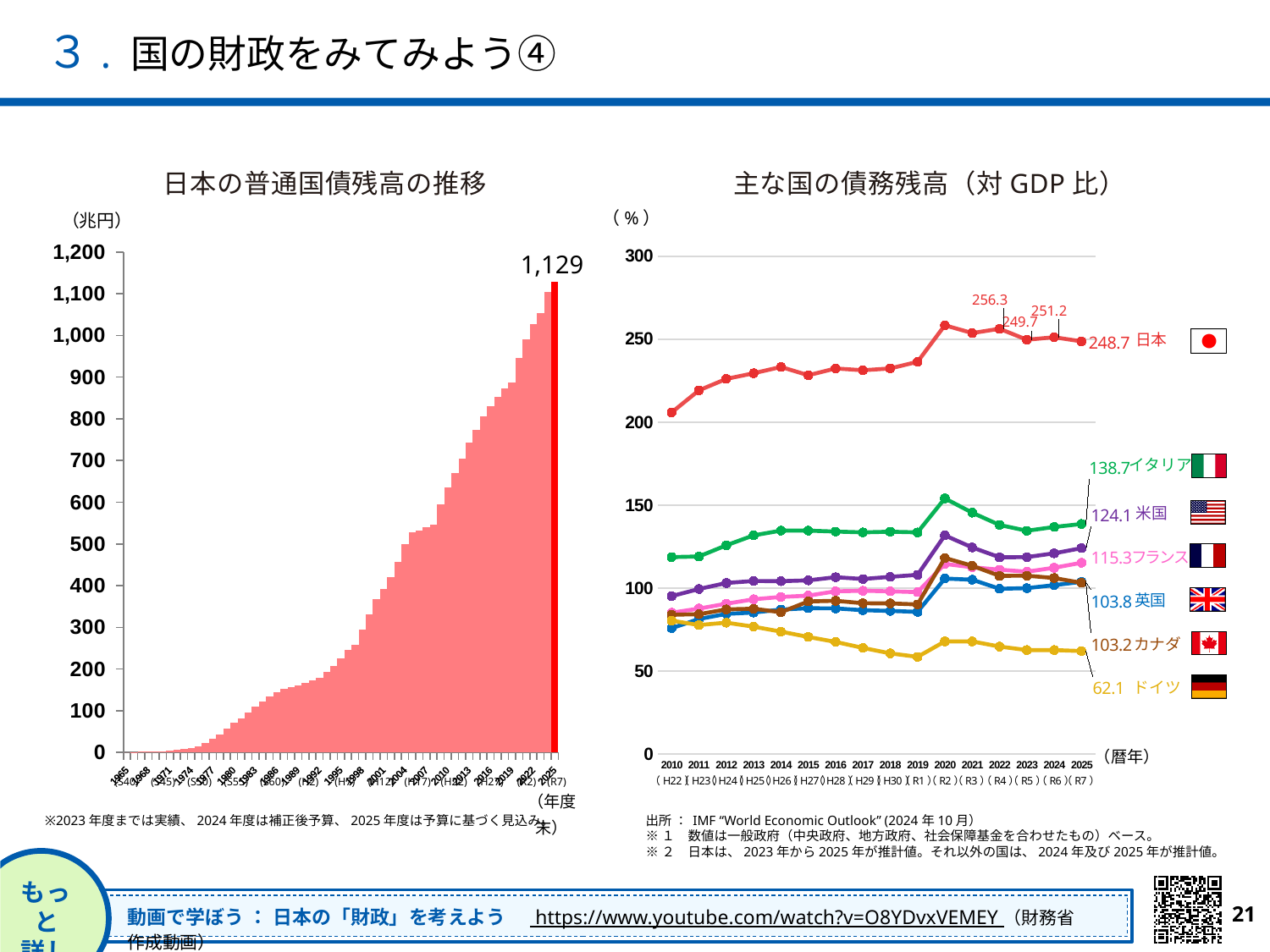
In the chart titled 主な国の債務残高（対GDP比）, what is the 2025 value for イタリア? 138.7 What kind of chart is the left chart, 日本の普通国債残高の推移? bar chart How many countries are plotted in the chart titled 主な国の債務残高（対GDP比）? 7 In the chart titled 日本の普通国債残高の推移, what is the value shown for 2025? 1,129 In the chart titled 日本の普通国債残高の推移, is the value for 1980 greater or less than 100? less In the chart titled 主な国の債務残高（対GDP比）, which country has the lowest value in 2025? ドイツ In the chart titled 主な国の債務残高（対GDP比）, what is the value for 日本 in 2025? 248.7 In the chart titled 主な国の債務残高（対GDP比）, what is the difference between the 2025 values for 日本 and イタリア? 110.0 In the chart titled 主な国の債務残高（対GDP比）, which country has the highest value in 2025? 日本 In the chart titled 主な国の債務残高（対GDP比）, which has the larger 2025 value, 英国 or カナダ? 英国 In the chart titled 日本の普通国債残高の推移, do the values generally rise or fall from 1965 to 2025? rise